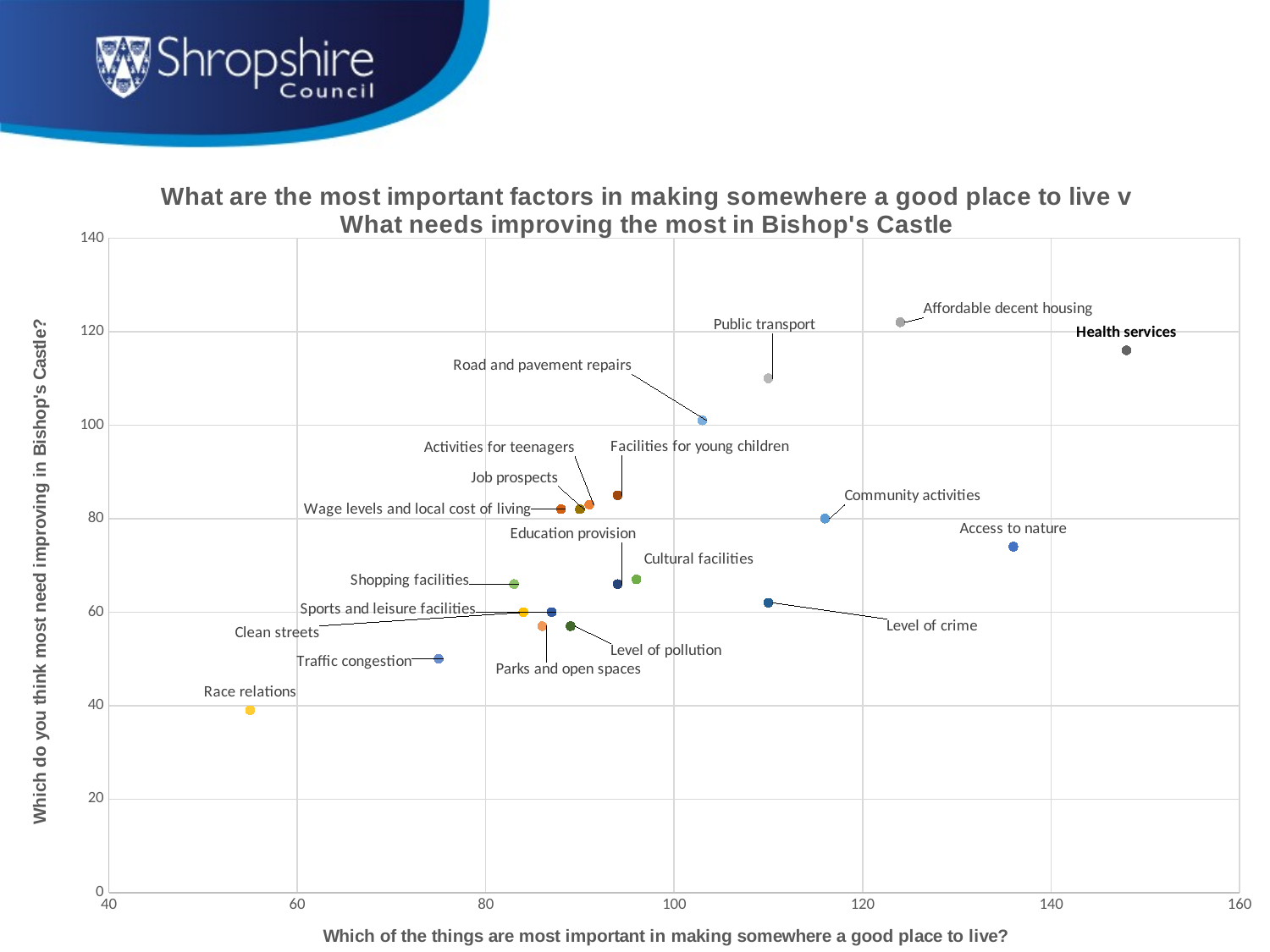
Is the vertical-axis value for Traffic congestion greater or less than 60? less Is the horizontal-axis value for Race relations greater or less than 60? less Which has the higher vertical-axis value, Public transport or Road and pavement repairs? Public transport What kind of chart is shown on the slide? Scatter chart What is the title of the horizontal axis? Which of the things are most important in making somewhere a good place to live? Is the vertical-axis value for Health services greater or less than 100? greater Which factor has the highest value on the horizontal axis (most important in making somewhere a good place to live)? Health services Which factor has the lowest value on the horizontal axis (most important in making somewhere a good place to live)? Race relations Which factor has the lowest value on the vertical axis (most need improving)? Race relations Which factor has the highest value on the vertical axis (most need improving)? Affordable decent housing How many labelled data points are plotted on the chart? 20